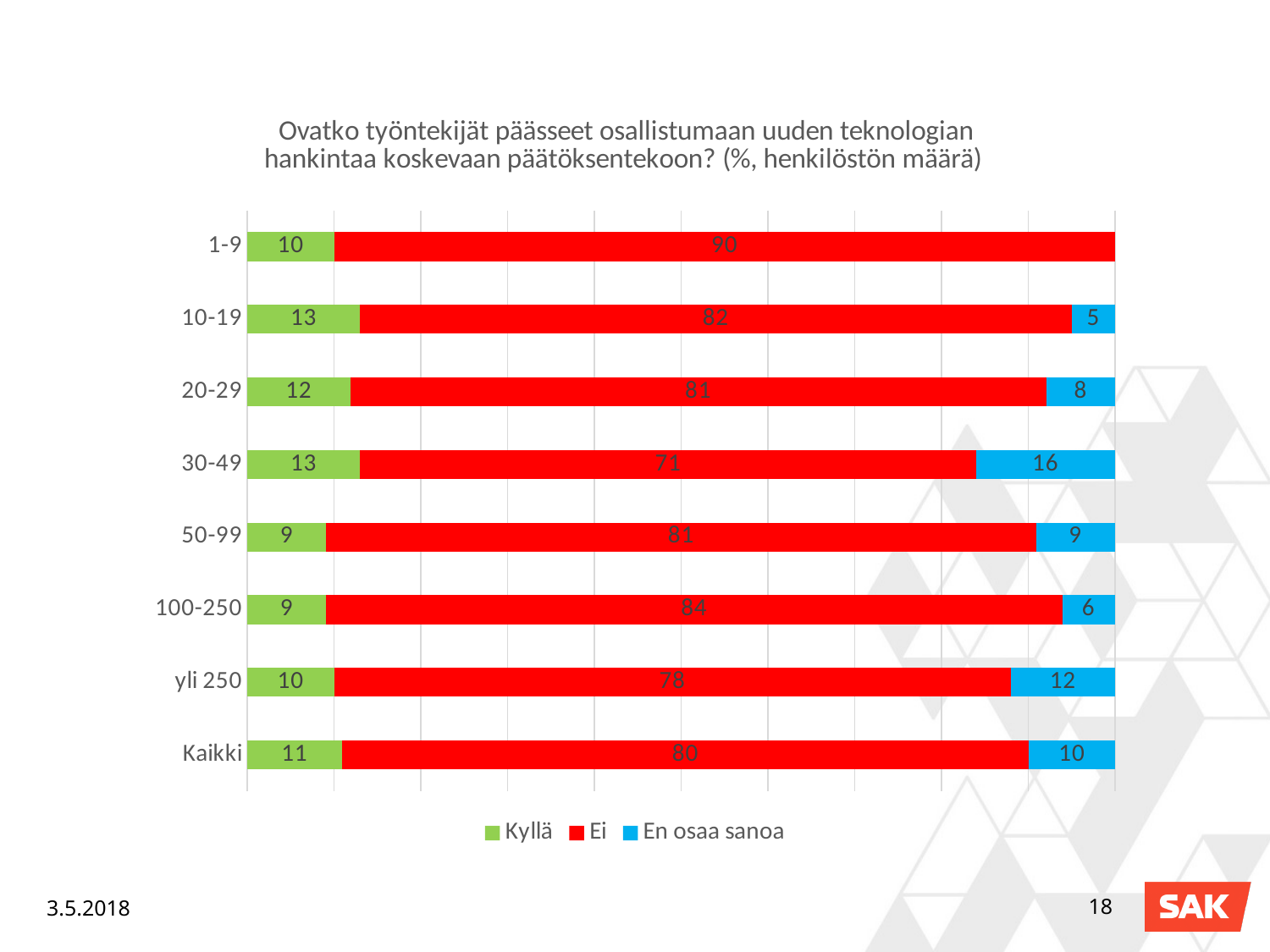
What is the value of "Kyllä" for the Kaikki category? 11 Which category has the highest value for "En osaa sanoa"? 30-49 Which series is shown in red? Ei What is the value of "Ei" for the 30-49 category? 71 What is the value of "En osaa sanoa" for the yli 250 category? 12 Which is larger, the "Kyllä" value for 10-19 or for 50-99? 10-19 Which category has the lowest value for "Ei"? 30-49 Which category has the highest value for "Ei"? 1-9 What is the difference between the "Ei" values for 1-9 and 30-49? 19 How many series does the legend list? 3 How many categories are shown on the y axis? 8 What kind of chart is shown on the slide? Stacked bar chart